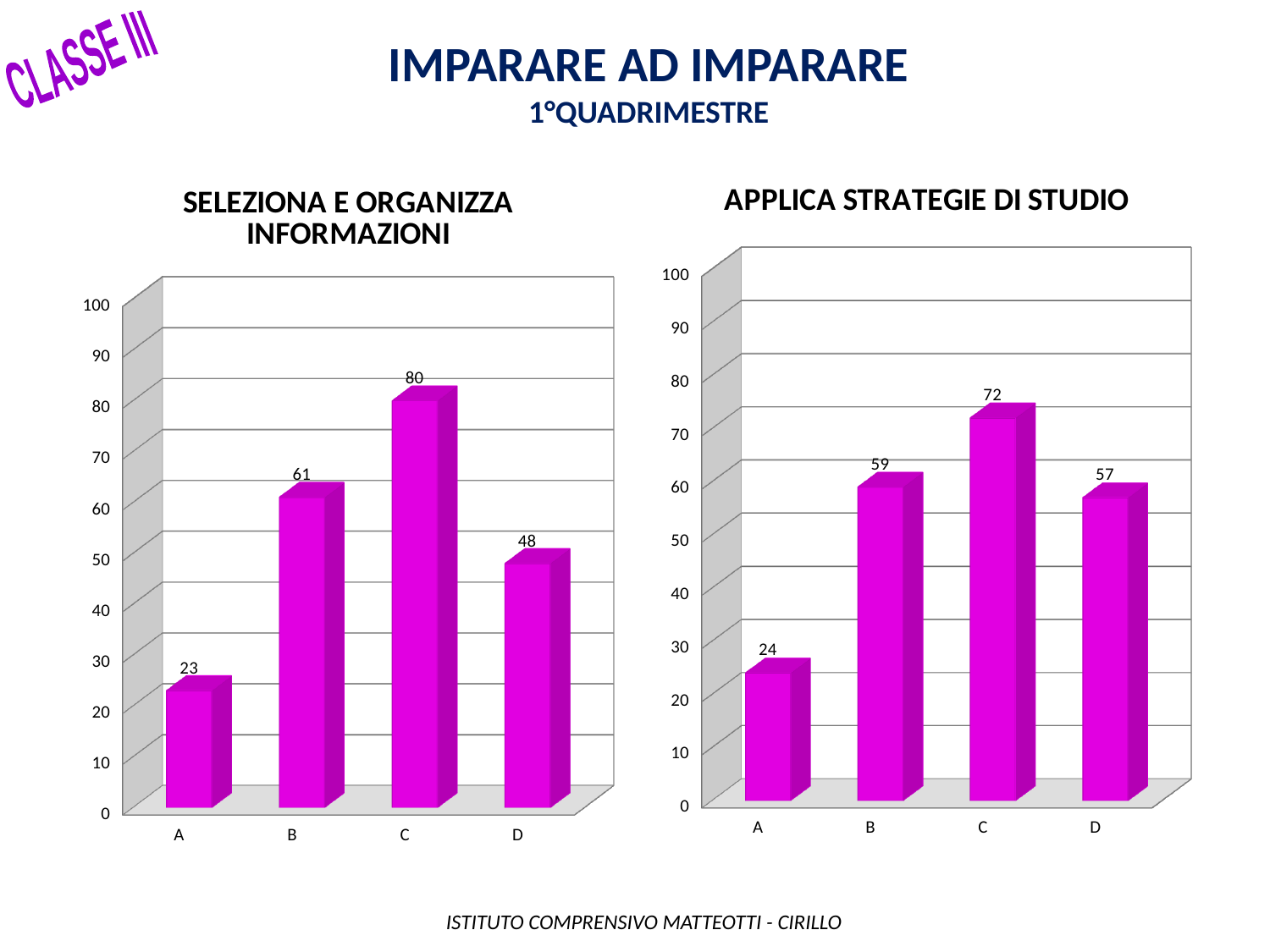
In the 'APPLICA STRATEGIE DI STUDIO' chart, is the value for D greater or less than 50? greater In the 'SELEZIONA E ORGANIZZA INFORMAZIONI' chart, which is larger, the value for B or the value for D? B How many categories are shown in the 'SELEZIONA E ORGANIZZA INFORMAZIONI' chart? 4 What kind of chart is the 'APPLICA STRATEGIE DI STUDIO' chart? bar chart In the 'SELEZIONA E ORGANIZZA INFORMAZIONI' chart, what is the difference between the values for C and D? 32 In the 'APPLICA STRATEGIE DI STUDIO' chart, what is the value for category A? 24 What colour are the bars in the 'APPLICA STRATEGIE DI STUDIO' chart? magenta In the 'SELEZIONA E ORGANIZZA INFORMAZIONI' chart, which category has the lowest value? A In the 'APPLICA STRATEGIE DI STUDIO' chart, what is the difference between the values for B and A? 35 In the 'APPLICA STRATEGIE DI STUDIO' chart, which category has the highest value? C In the 'SELEZIONA E ORGANIZZA INFORMAZIONI' chart, what is the value for category B? 61 In the 'SELEZIONA E ORGANIZZA INFORMAZIONI' chart, what is the value for category C? 80